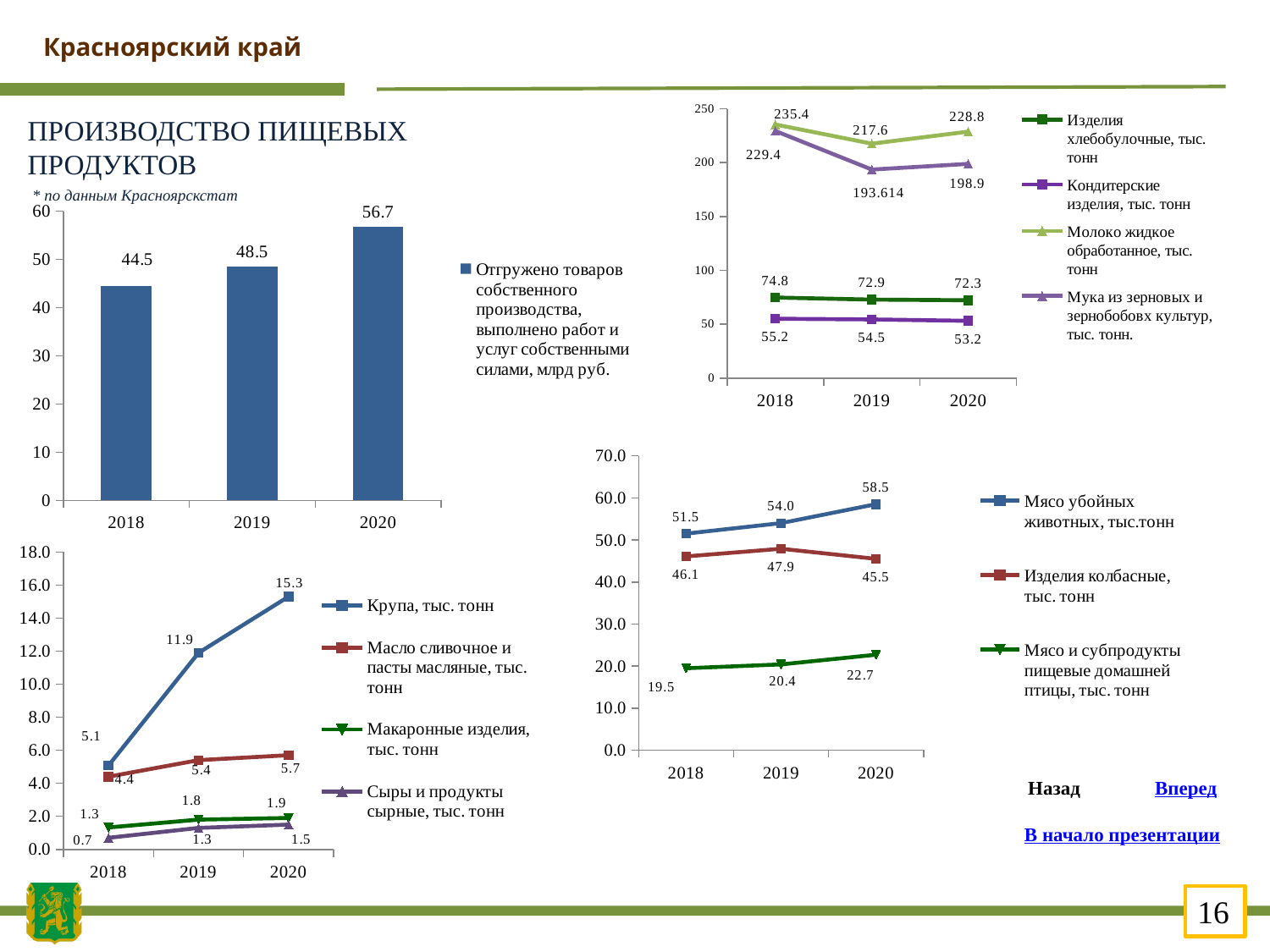
In the top-left bar chart, what is the difference between the 2020 and 2018 values? 12.2 In the bottom-right line chart, what is the value for Мясо убойных животных, тыс.тонн in 2020? 58.5 In the top-left bar chart, what is the value for 2020? 56.7 In the bottom-left line chart, what is the value for Крупа, тыс. тонн in 2019? 11.9 In the bottom-right line chart, which is larger in 2019: Изделия колбасные or Мясо и субпродукты пищевые домашней птицы? Изделия колбасные In the bottom-left line chart, which series has the lowest value in 2018? Сыры и продукты сырные, тыс. тонн In the top-right line chart, what is the value for Мука из зерновых и зернобобовх культур in 2019? 193.614 What type of chart is the top-left chart on the slide? bar chart How many series does the legend of the bottom-left line chart list? 4 In the top-right line chart, which series has the highest value in 2020? Молоко жидкое обработанное, тыс. тонн In the top-right line chart, is the value for Кондитерские изделия in 2018 greater or less than 50? greater In the top-left bar chart, do the values rise or fall from 2018 to 2020? rise